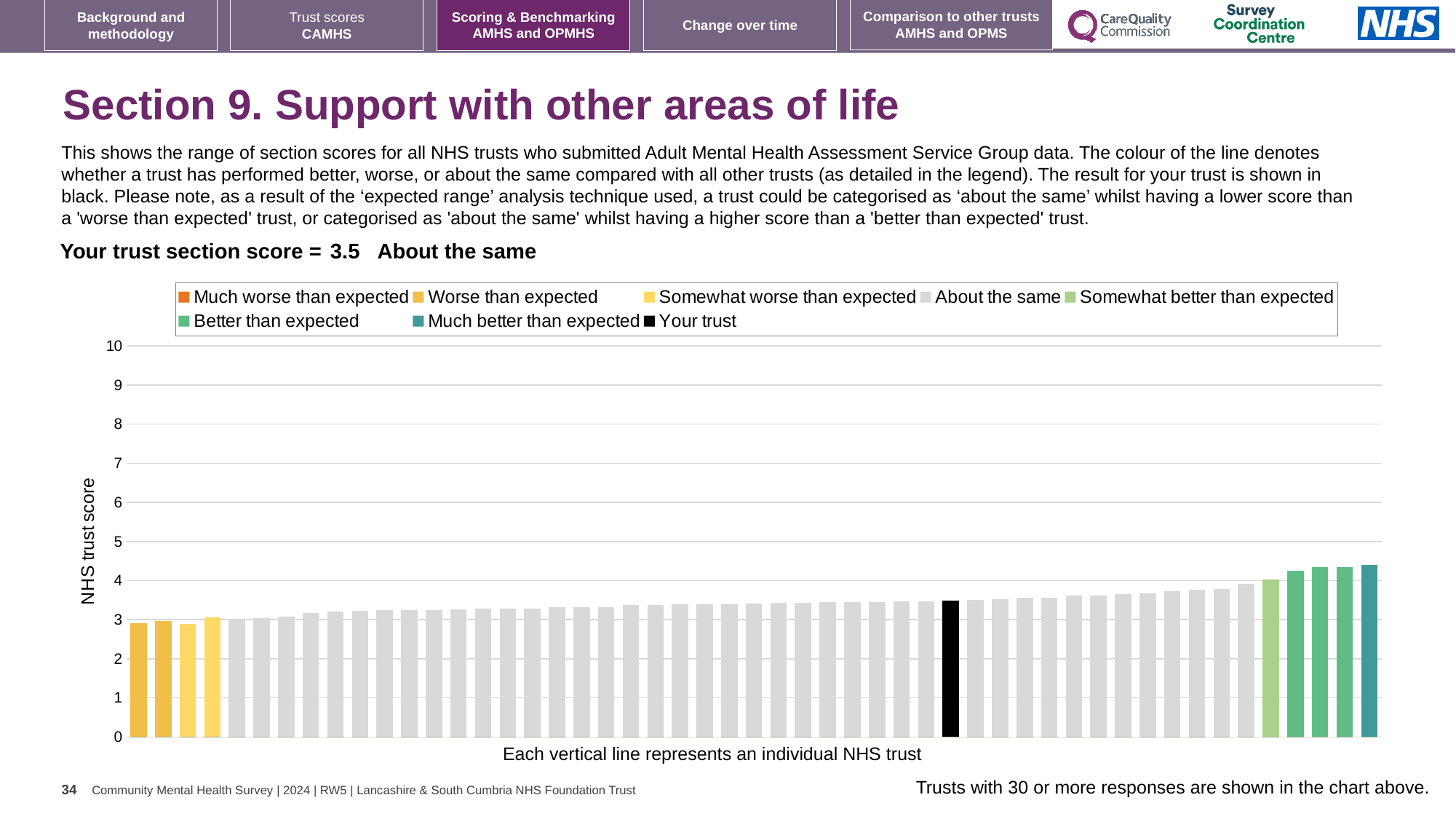
Is the value of the shortest bar in the chart greater or less than 2? greater What type of chart is shown on the slide? Bar chart How many entries does the chart legend list? 8 Is the value of the black 'Your trust' bar greater or less than 4? less Do the bar values rise or fall from left to right along the x axis? Rise How many bars are coloured as 'Much worse than expected'? 0 What is the label on the vertical axis of the chart? NHS trust score Which is larger: the 'Your trust' bar or the 'Much better than expected' bar? Much better than expected Is the value of the tallest bar in the chart greater or less than 4? greater What is the section score for your trust (the black bar)? 3.5 How many bars are coloured as 'Much better than expected'? 1